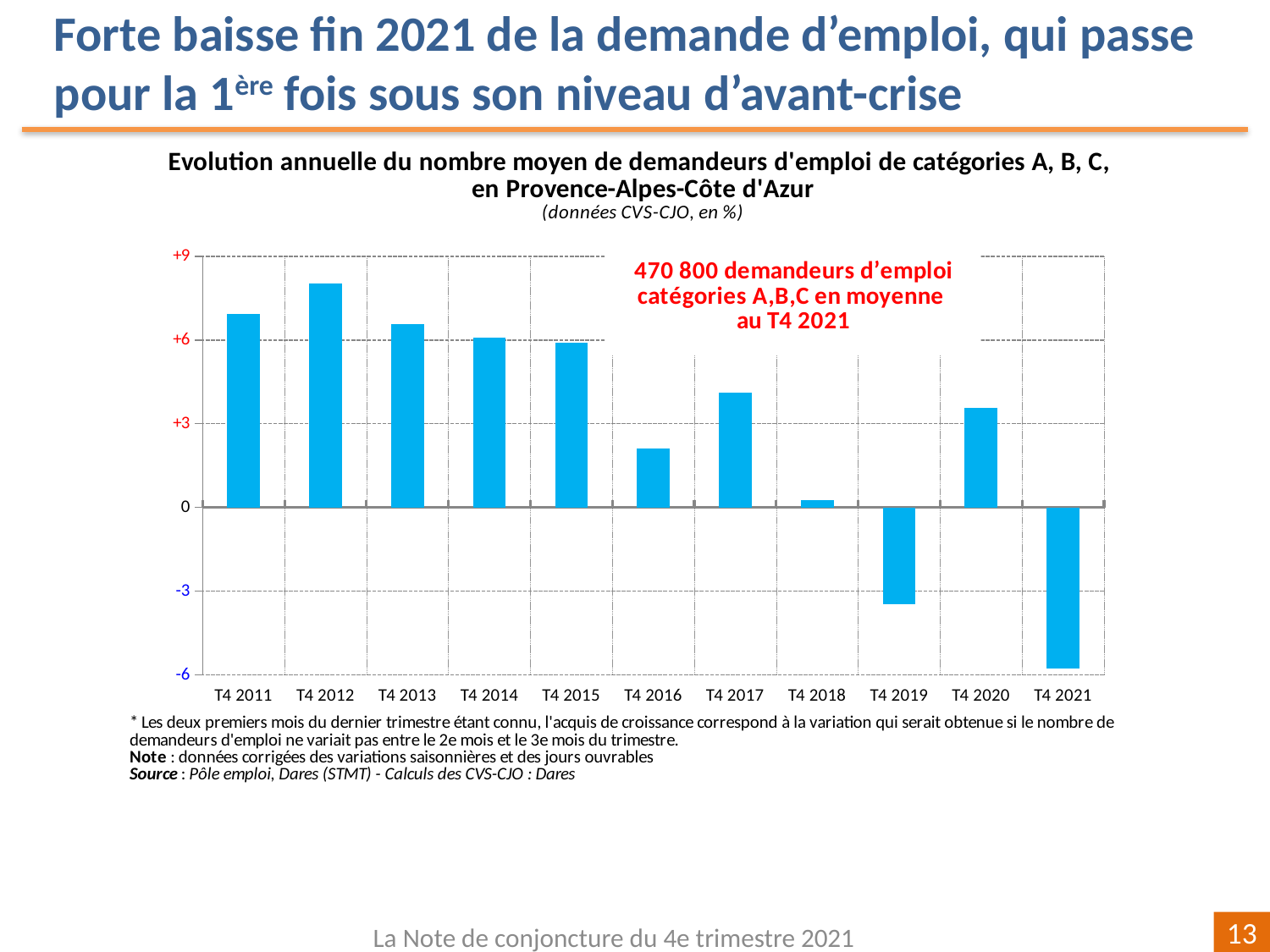
Which quarter has the lowest value on the chart? T4 2021 Which quarter has the highest value on the chart? T4 2012 Do the values generally rise or fall from T4 2011 to T4 2016? fall According to the annotation on the chart, how many demandeurs d'emploi catégories A,B,C were there on average in T4 2021? 470 800 How many quarters (bars) are plotted on the chart? 11 Which is larger, the value for T4 2017 or the value for T4 2016? T4 2017 Is the value for T4 2012 greater or less than +6? greater Is the value for T4 2019 greater or less than -3? less Is the value for T4 2021 greater or less than -3? less Which is larger, the value for T4 2011 or the value for T4 2020? T4 2011 What kind of chart is shown on the slide? bar chart